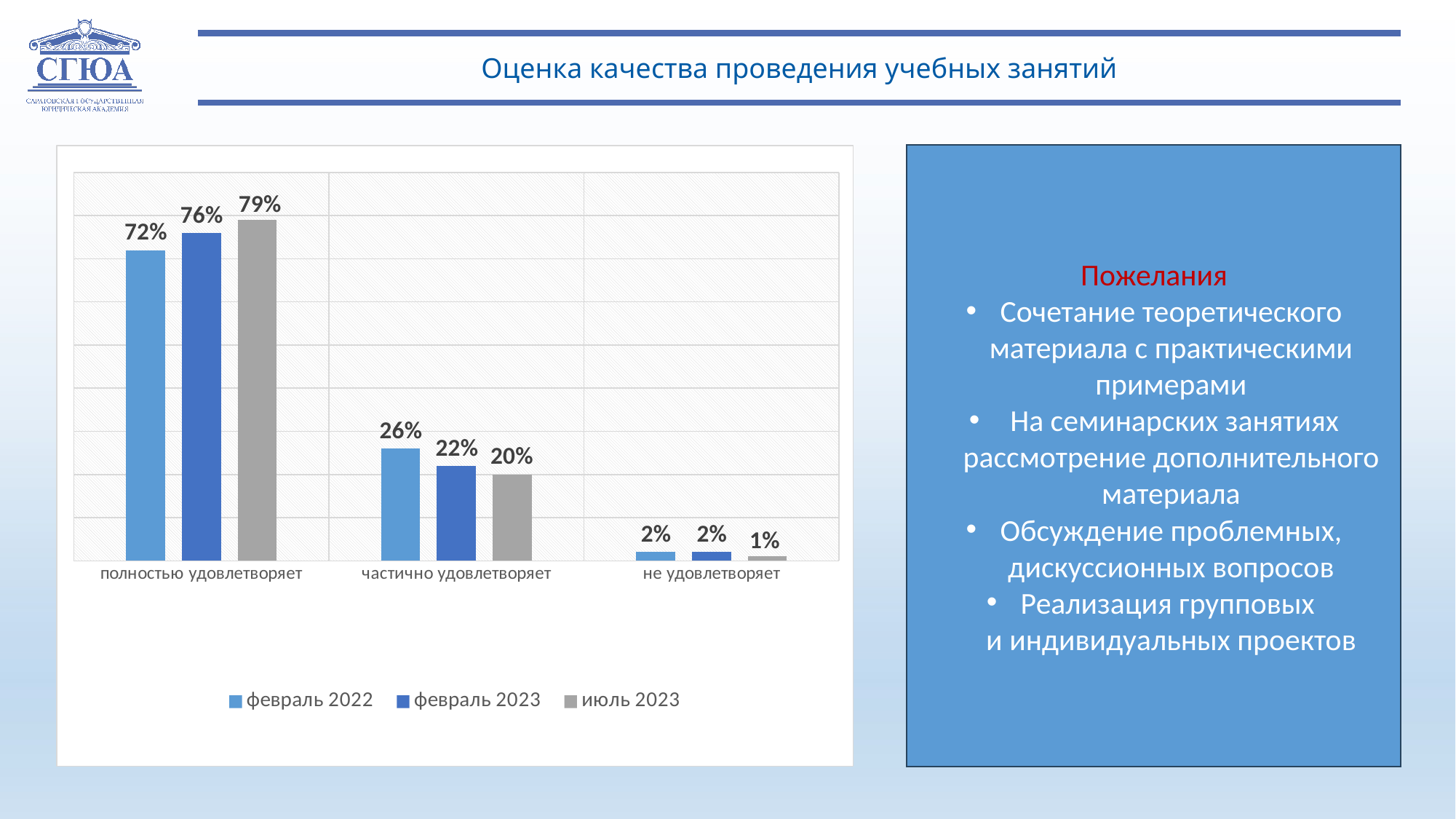
Which is larger for 'частично удовлетворяет': the 'февраль 2022' value or the 'февраль 2023' value? февраль 2022 What kind of chart is shown on the slide? bar chart Which category has the lowest value in the 'февраль 2022' series? не удовлетворяет How many series does the legend list? 3 Do the values for 'полностью удовлетворяет' rise or fall from 'февраль 2022' to 'июль 2023'? rise What is the title of the slide above the chart? Оценка качества проведения учебных занятий How many categories are shown on the x axis? 3 What is the value for 'частично удовлетворяет' in the 'июль 2023' series? 20% What is the difference between the 'июль 2023' and 'февраль 2022' values for 'полностью удовлетворяет'? 7% What is the value for 'полностью удовлетворяет' in the 'февраль 2022' series? 72% Which category has the highest value in the 'июль 2023' series? полностью удовлетворяет What is the value for 'не удовлетворяет' in the 'февраль 2023' series? 2%